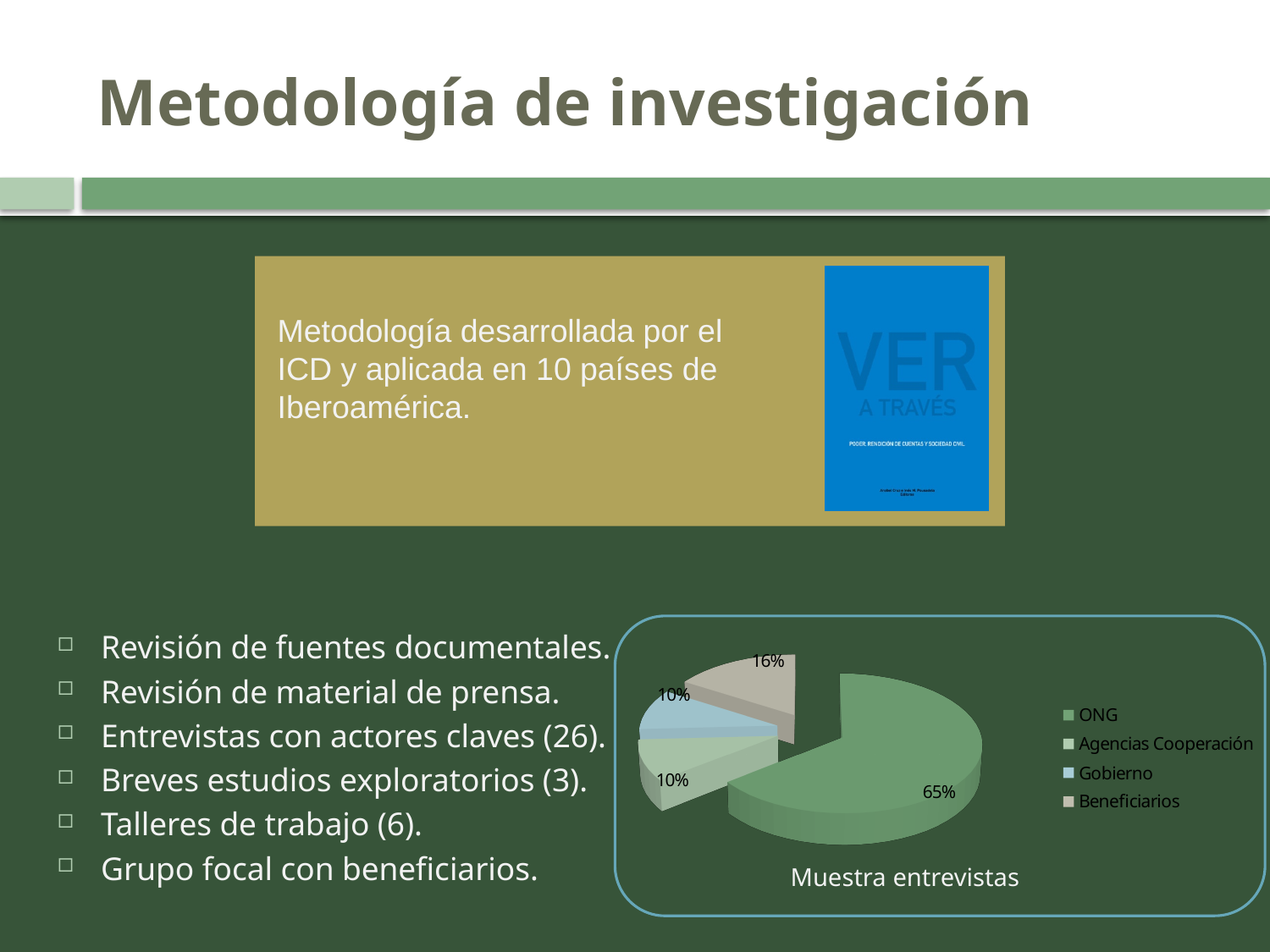
Which is larger in the pie chart, the share for ONG or the share for Beneficiarios? ONG What share of the pie chart corresponds to Agencias Cooperación? 10% What share of the pie chart corresponds to Beneficiarios? 16% What is the difference in percentage points between the ONG share and the Beneficiarios share? 49 What kind of chart is shown on the slide? pie chart Which category has the largest slice in the pie chart? ONG What is the title of the pie chart? Muestra entrevistas What share of the pie chart corresponds to ONG? 65% What is the difference in percentage points between the Beneficiarios share and the Gobierno share? 6 How many categories does the legend of the pie chart list? 4 How many slices does the pie chart have? 4 What share of the pie chart corresponds to Gobierno? 10%